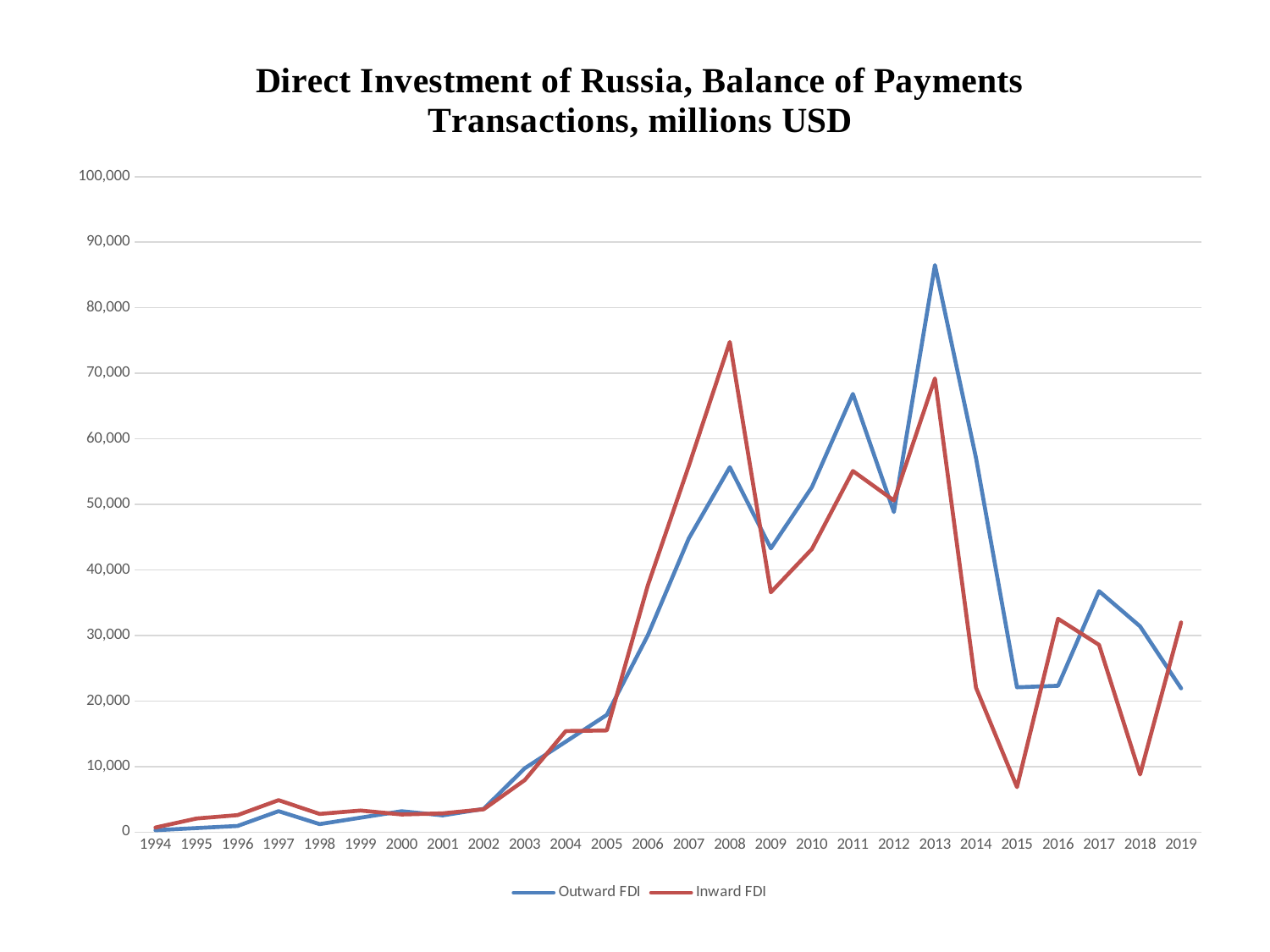
In which year is Outward FDI at its lowest? 1994 How many years are plotted along the x axis? 26 In which year does Outward FDI reach its highest value? 2013 How many series does the legend list? 2 In 2008, which series has the larger value, Outward FDI or Inward FDI? Inward FDI Is the value of Outward FDI in 2013 greater or less than 80,000? greater Is the value of Inward FDI in 2008 greater or less than 70,000? greater In which year does Inward FDI reach its highest value? 2008 Does Inward FDI rise or fall from 2002 to 2008? Rise Is the value of Inward FDI in 2015 greater or less than 10,000? less What kind of chart is shown on the slide? Line chart In 2017, which series has the larger value, Outward FDI or Inward FDI? Outward FDI